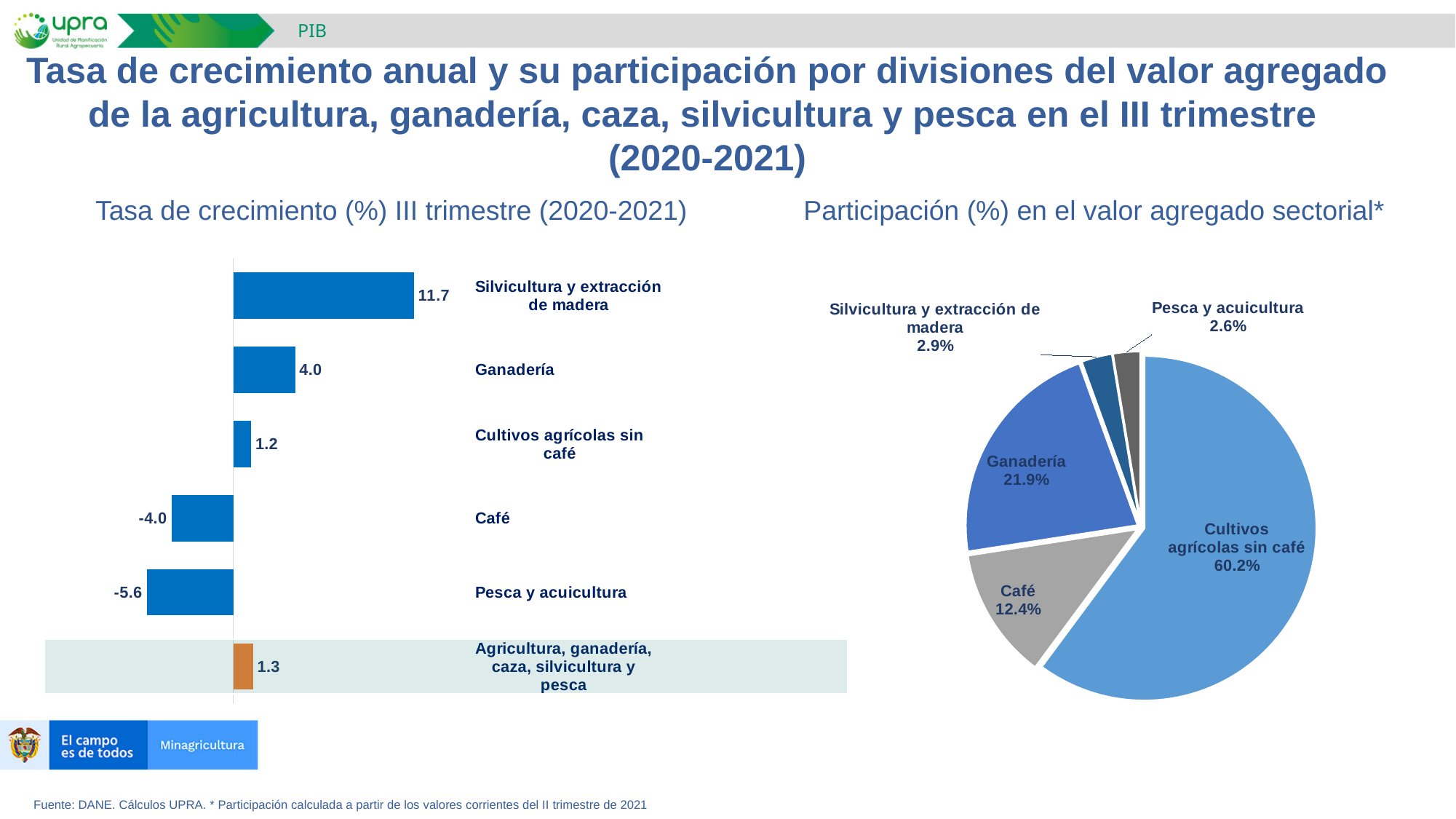
In the pie chart 'Participación (%) en el valor agregado sectorial*', which is larger, Ganadería or Café? Ganadería In the bar chart 'Tasa de crecimiento (%) III trimestre (2020-2021)', how many categories are shown? 6 In the bar chart 'Tasa de crecimiento (%) III trimestre (2020-2021)', which category has the highest value? Silvicultura y extracción de madera In the bar chart 'Tasa de crecimiento (%) III trimestre (2020-2021)', which category has the lowest value? Pesca y acuicultura In the bar chart 'Tasa de crecimiento (%) III trimestre (2020-2021)', what is the difference between the values for Ganadería and Cultivos agrícolas sin café? 2.8 In the bar chart 'Tasa de crecimiento (%) III trimestre (2020-2021)', what is the value for Silvicultura y extracción de madera? 11.7 In the bar chart 'Tasa de crecimiento (%) III trimestre (2020-2021)', what is the value for Pesca y acuicultura? -5.6 In the pie chart 'Participación (%) en el valor agregado sectorial*', what is the share for Cultivos agrícolas sin café? 60.2% What kind of chart is the one on the left of the slide? Bar chart In the pie chart 'Participación (%) en el valor agregado sectorial*', which slice is the smallest? Pesca y acuicultura In the pie chart 'Participación (%) en el valor agregado sectorial*', what is the value for Café? 12.4% What kind of chart is the one on the right of the slide? Pie chart